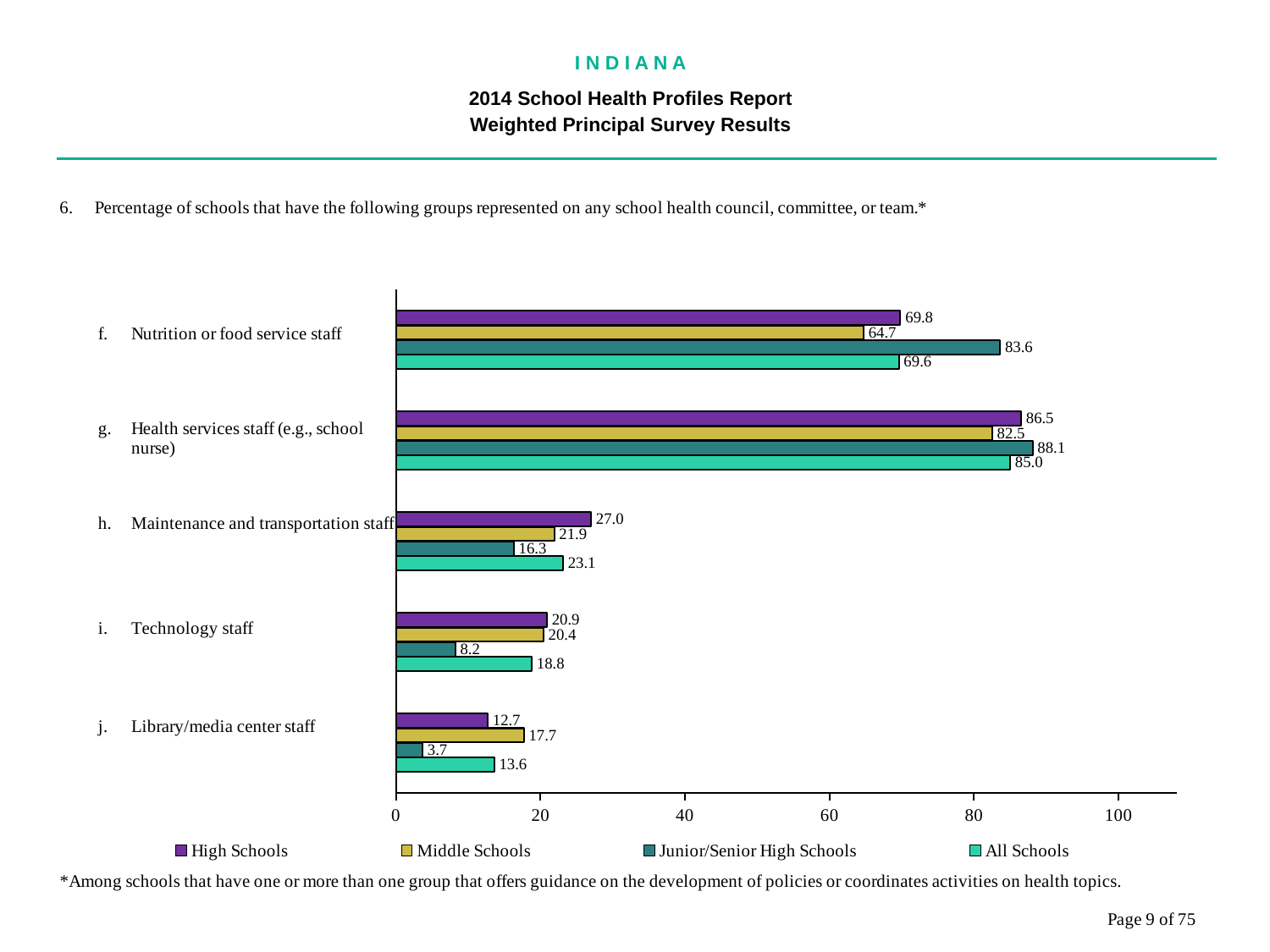
What kind of chart is shown on the slide? bar chart Is the value for Junior/Senior High Schools for Nutrition or food service staff greater or less than 80? greater What is the value for All Schools for Health services staff (e.g., school nurse)? 85.0 What is the difference between the High Schools and Middle Schools values for Maintenance and transportation staff? 5.1 Which category has the highest value for Middle Schools? Health services staff (e.g., school nurse) What is the value for Junior/Senior High Schools for Technology staff? 8.2 How many series does the legend list? 4 What is the value for High Schools for Nutrition or food service staff? 69.8 How many categories are shown on the chart? 5 Which series is shown in the legend with a yellow colour? Middle Schools Which is larger for Library/media center staff: the Middle Schools value or the High Schools value? Middle Schools Which category has the lowest value for Junior/Senior High Schools? Library/media center staff